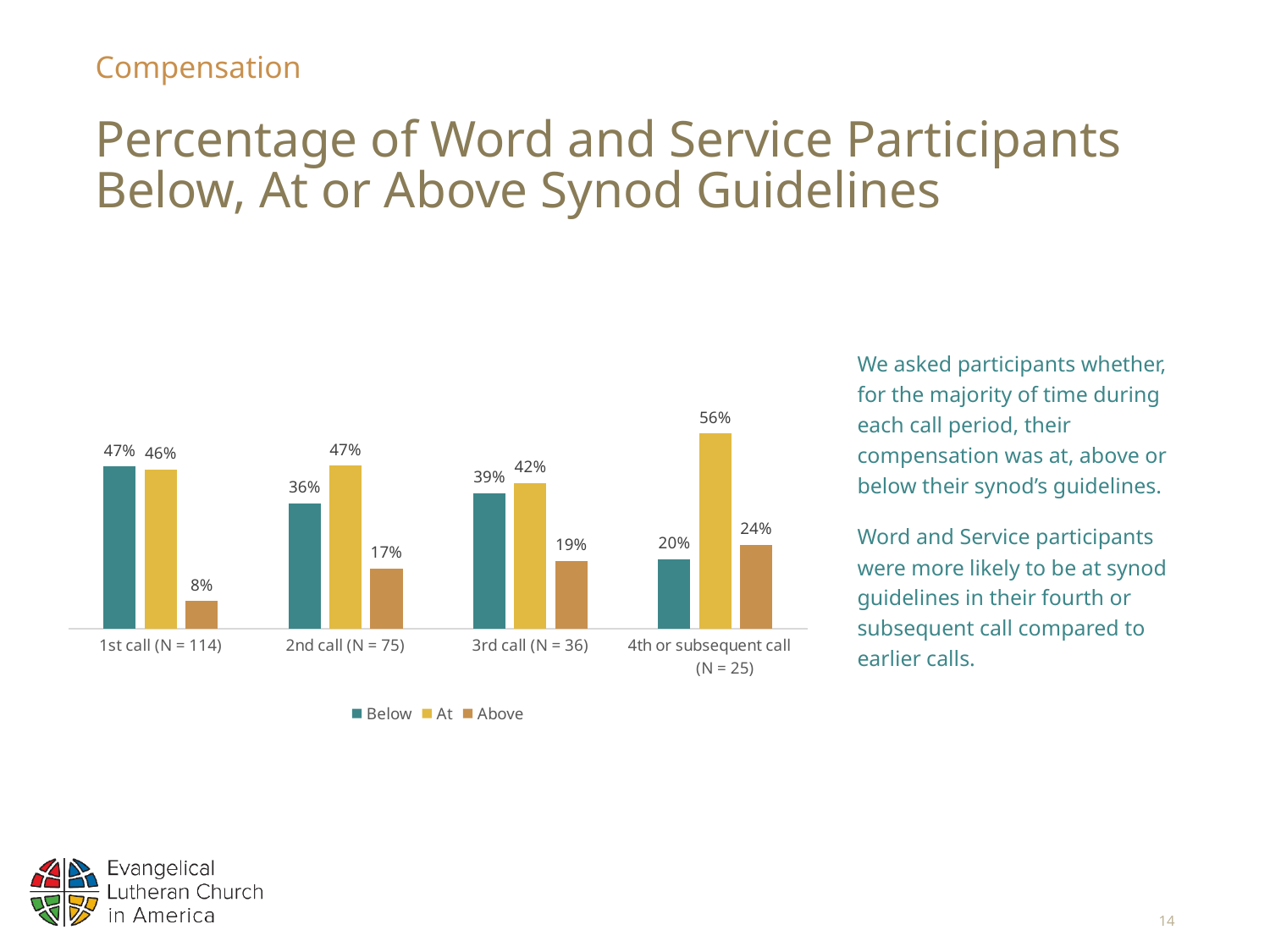
How many call categories are shown on the x axis? 4 What percentage of 1st call (N = 114) participants were Below synod guidelines? 47% What percentage of 4th or subsequent call (N = 25) participants were At synod guidelines? 56% What kind of chart is shown on the slide? Bar chart Does the Below percentage rise or fall from 1st call to 4th or subsequent call? Fall Which call category has the lowest percentage of participants Above synod guidelines? 1st call (N = 114) Which call category has the highest percentage of participants At synod guidelines? 4th or subsequent call (N = 25) Which is larger for the 2nd call (N = 75): the Below percentage or the At percentage? At How many series does the legend list? 3 What percentage of 3rd call (N = 36) participants were Below synod guidelines? 39% What is the difference between the At and Above percentages for the 4th or subsequent call (N = 25)? 32% What percentage of 2nd call (N = 75) participants were Above synod guidelines? 17%